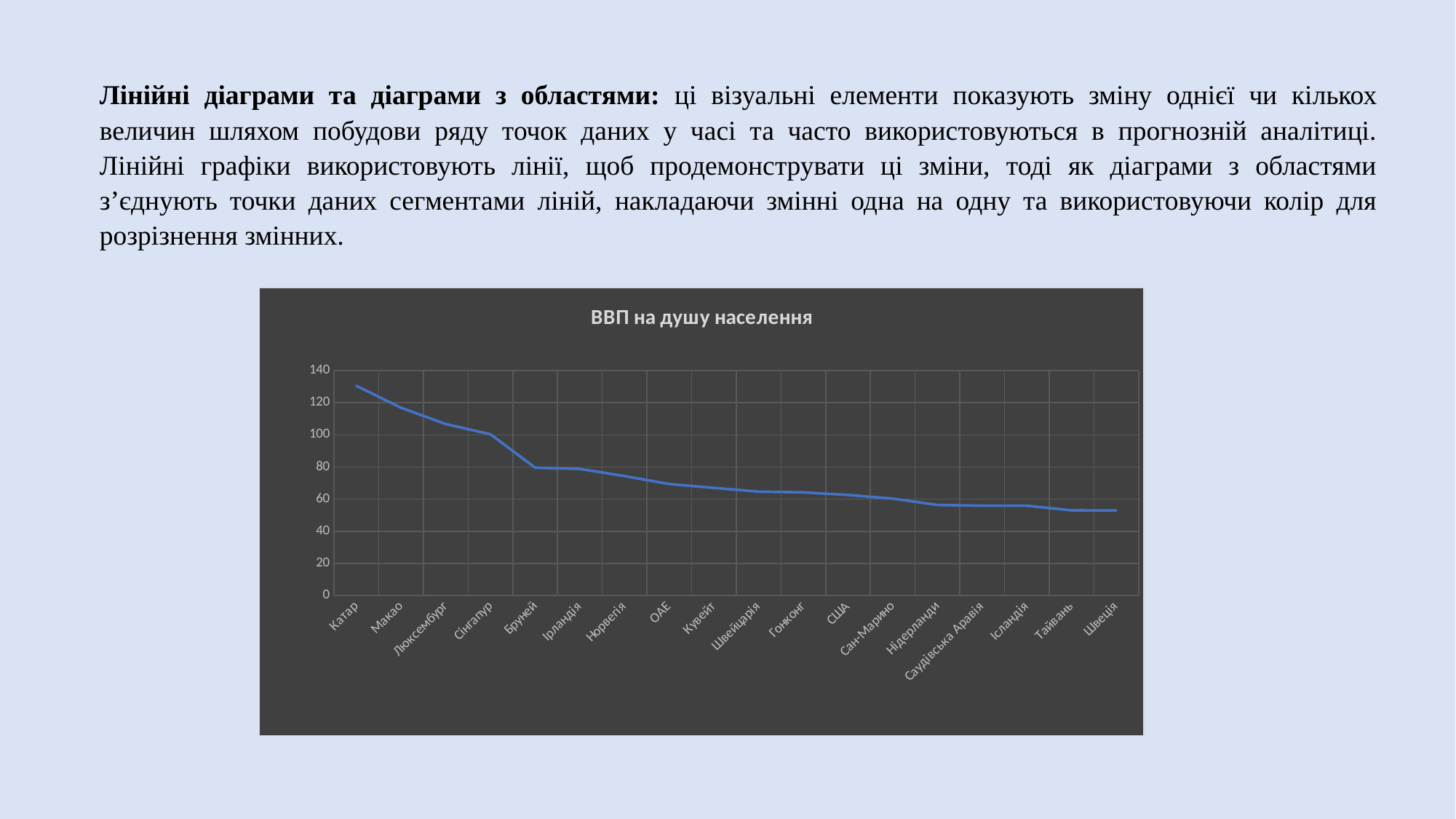
What is the title of the chart? ВВП на душу населення Is the value for Макао greater or less than 100? greater Is the value for Швеція greater or less than 40? greater Is the value for Норвегія greater or less than 80? less Which country has the highest value in the chart? Катар Which has the larger value, Люксембург or Бруней? Люксембург What kind of chart is shown on the slide? line chart How many countries are plotted on the x axis of the chart? 18 Do the values rise or fall moving from left to right along the x axis? fall Which country is plotted first on the x axis? Катар